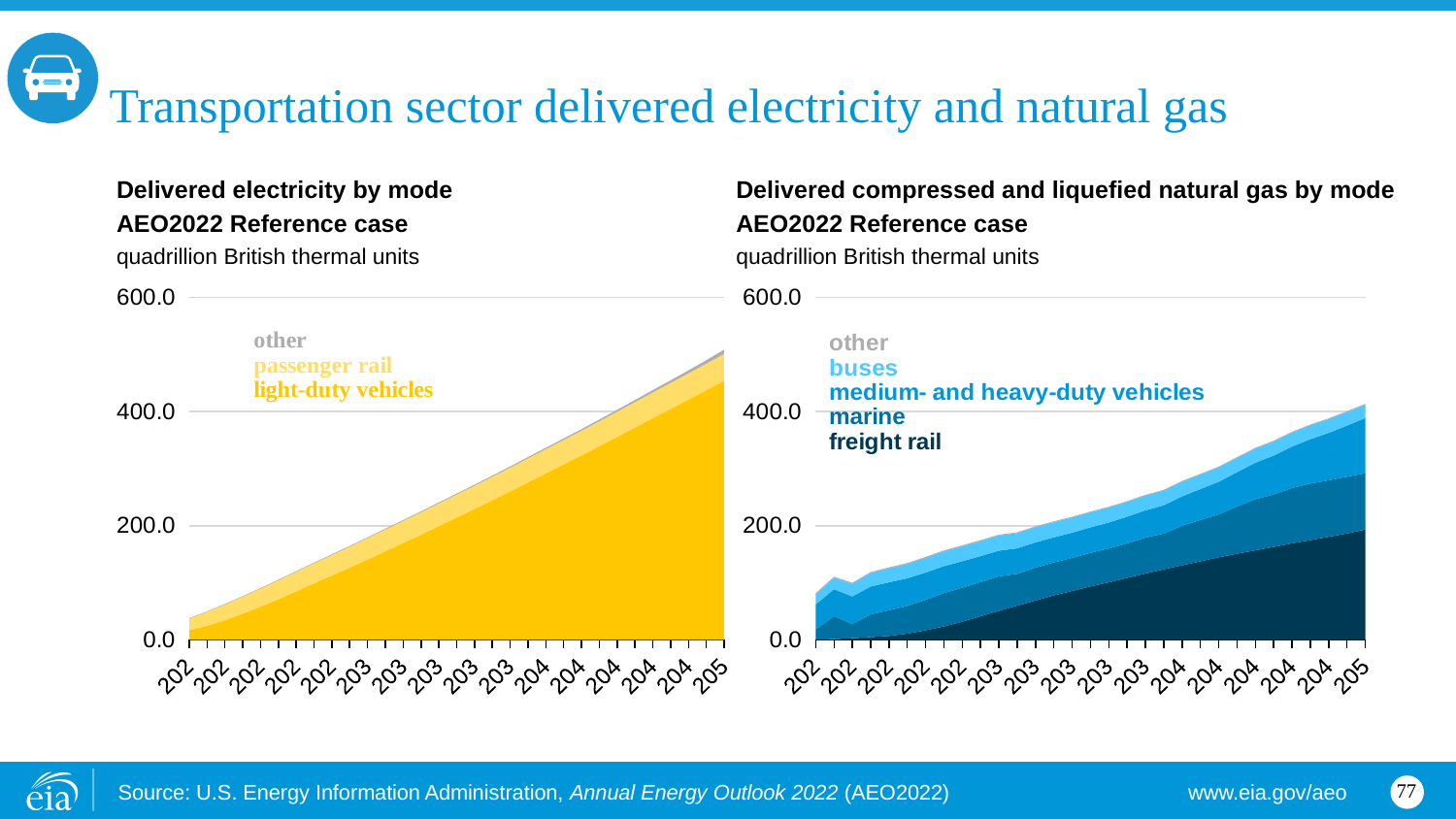
In the 'Delivered electricity by mode' chart, is the total at the left end of the x axis greater or less than 200.0? less Which chart reaches a higher total at the right end of the x axis, the left chart or the right chart? the left chart (Delivered electricity by mode) What unit is shown under the titles of both charts? quadrillion British thermal units In the 'Delivered electricity by mode' chart, do the stacked values rise or fall along the x axis? rise In the 'Delivered electricity by mode' chart, is the total at the right end of the x axis greater or less than 400.0? greater How many series does the legend of the 'Delivered compressed and liquefied natural gas by mode' chart list? 5 Which series makes up the largest share of the 'Delivered electricity by mode' chart? light-duty vehicles How many series does the legend of the 'Delivered electricity by mode' chart list? 3 In the 'Delivered compressed and liquefied natural gas by mode' chart, is the total at the right end of the x axis greater or less than 200.0? greater What kind of chart is the 'Delivered electricity by mode' chart on the left? area chart In the 'Delivered compressed and liquefied natural gas by mode' chart, do the stacked values rise or fall overall along the x axis? rise